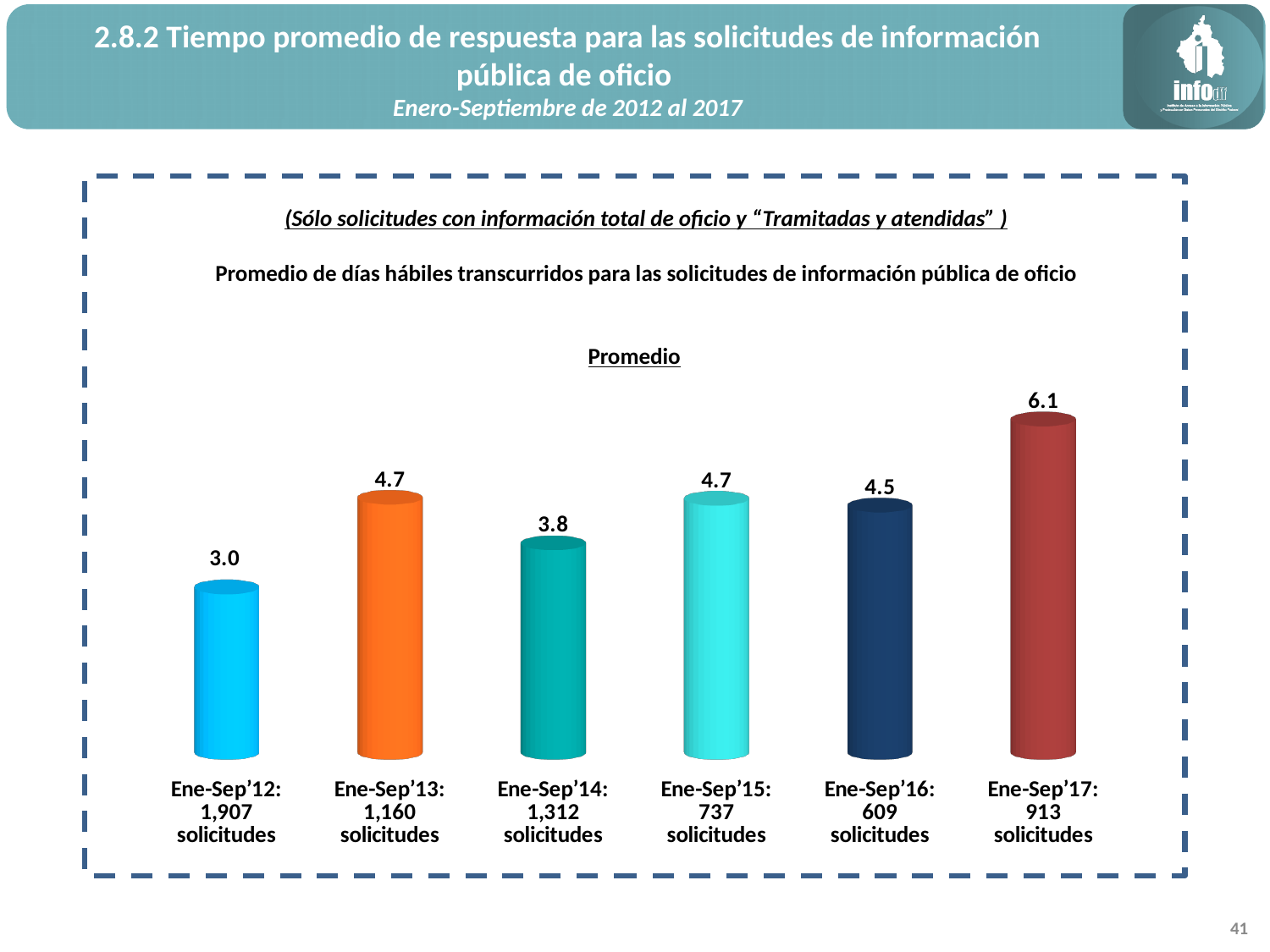
Which has a larger Promedio value, Ene-Sep'16 or Ene-Sep'17? Ene-Sep'17 What kind of chart is shown on the slide? Bar chart What is the Promedio value shown for Ene-Sep'17? 6.1 Which period has the highest Promedio value? Ene-Sep'17 What is the difference between the Promedio values for Ene-Sep'13 and Ene-Sep'14? 0.9 What is the difference between the Promedio values for Ene-Sep'17 and Ene-Sep'12? 3.1 How many solicitudes are indicated for Ene-Sep'12 in the category label? 1,907 What is the Promedio value shown for Ene-Sep'14? 3.8 What is the title of the chart? Promedio de días hábiles transcurridos para las solicitudes de información pública de oficio What is the average number of business days (Promedio) for Ene-Sep'12? 3.0 Which period has the lowest Promedio value? Ene-Sep'12 How many periods (bars) are shown in the chart? 6